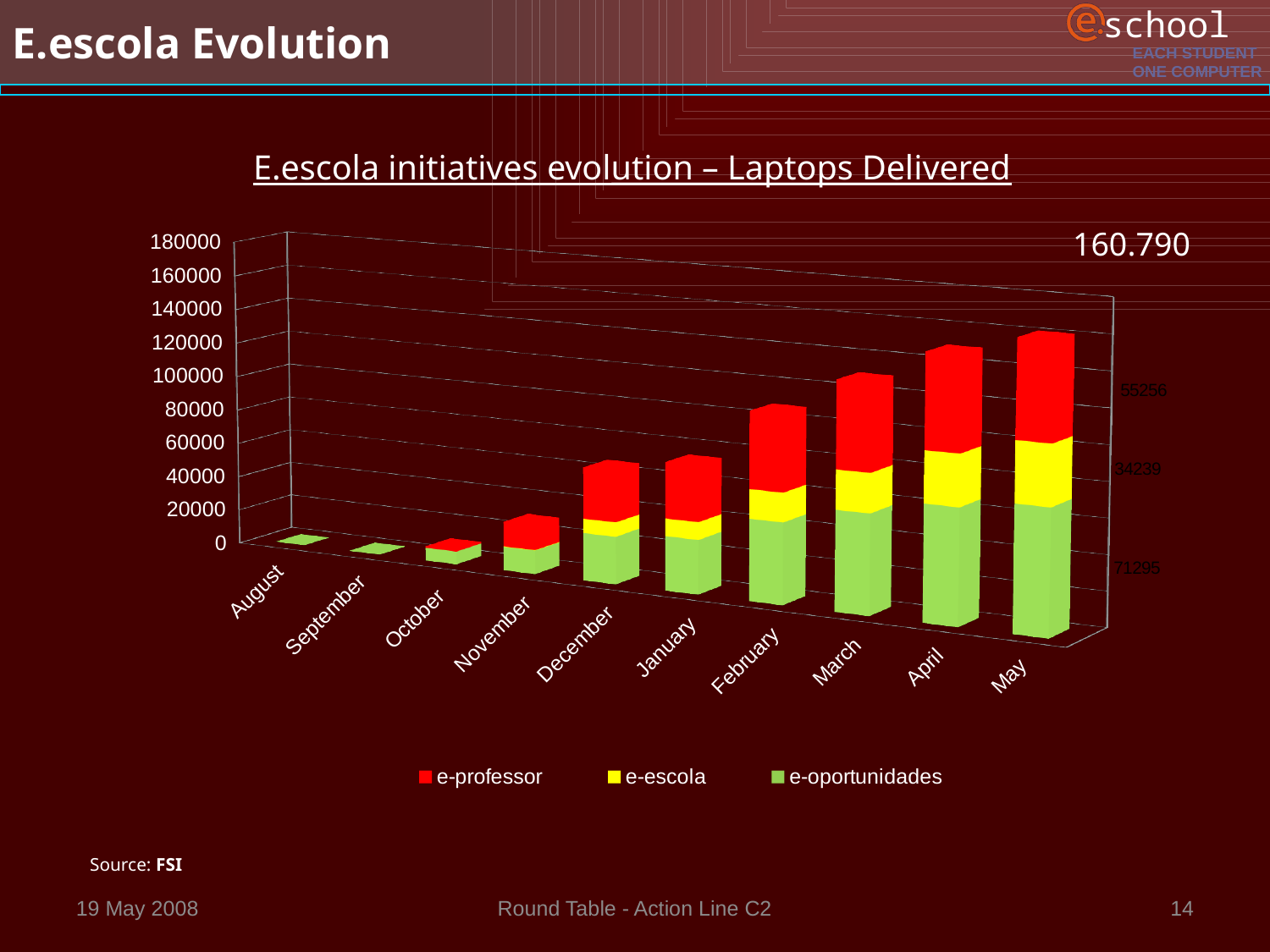
How many series does the chart legend list? 3 Which month has the highest total of laptops delivered? May Is the total for August greater or less than 20000? less What kind of chart is shown on the slide? bar chart In May, what is the difference between the e-oportunidades value and the e-professor value? 16039 Which colour represents e-escola in the chart? yellow What is the value of e-professor for May? 55256 What is the value of e-oportunidades for May? 71295 How many months are shown on the x axis of the chart? 10 Do the totals rise or fall from August to May? rise What total number of laptops delivered is shown for May? 160.790 What is the value of e-escola for May? 34239